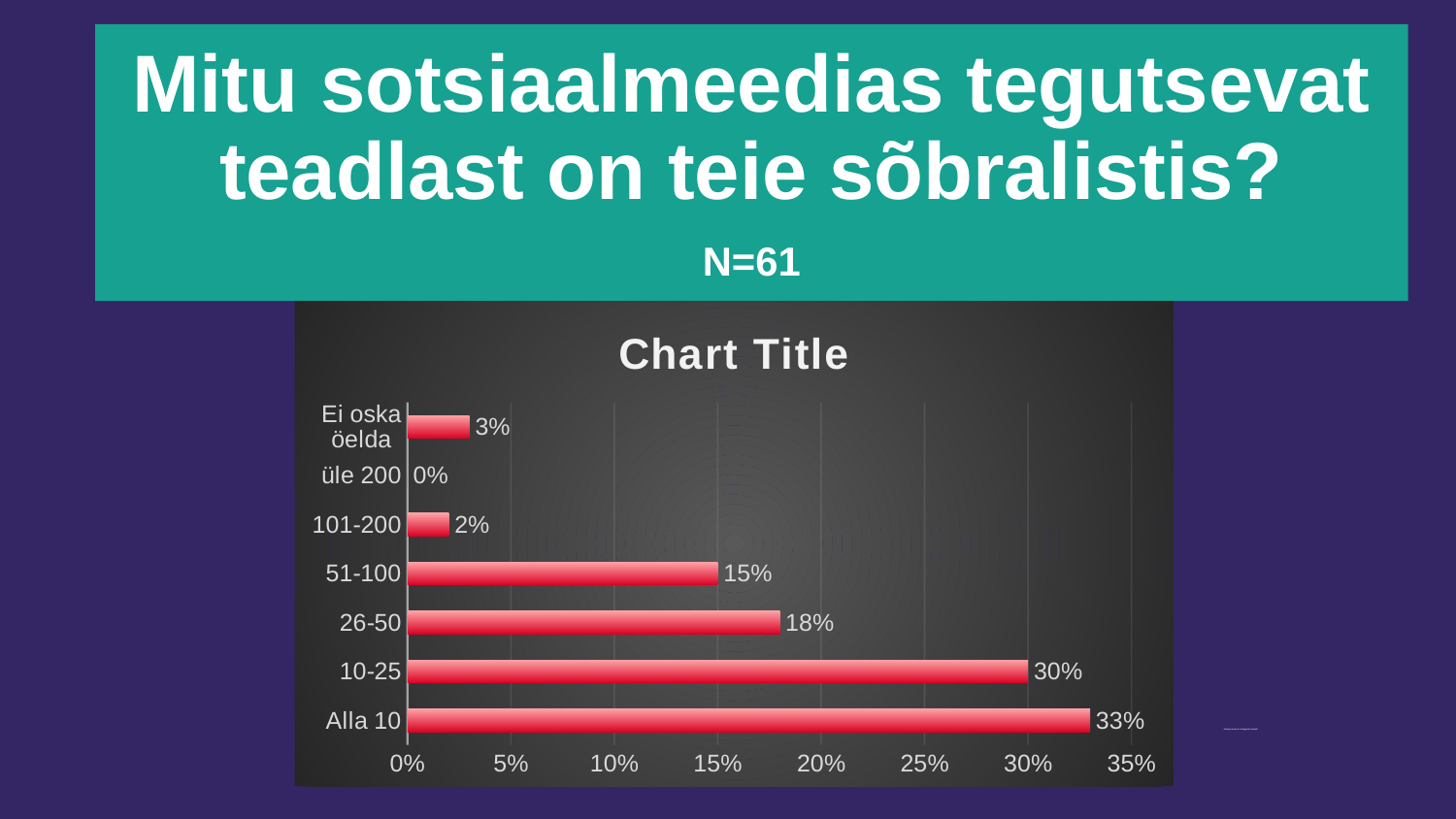
What is the difference between the values for "Alla 10" and "10-25"? 3% What is the value for the category "51-100"? 15% What is the title printed above the chart? Chart Title What is the value for the category "üle 200"? 0% Which category has the highest value? Alla 10 What is the difference between the values for "Ei oska öelda" and "101-200"? 1% Which is larger, the value for "26-50" or the value for "51-100"? 26-50 Which category has the lowest value? üle 200 What is the value for the category "Alla 10"? 33% How many categories are shown on the chart? 7 What is the value for the category "10-25"? 30% What kind of chart is shown on the slide? Bar chart